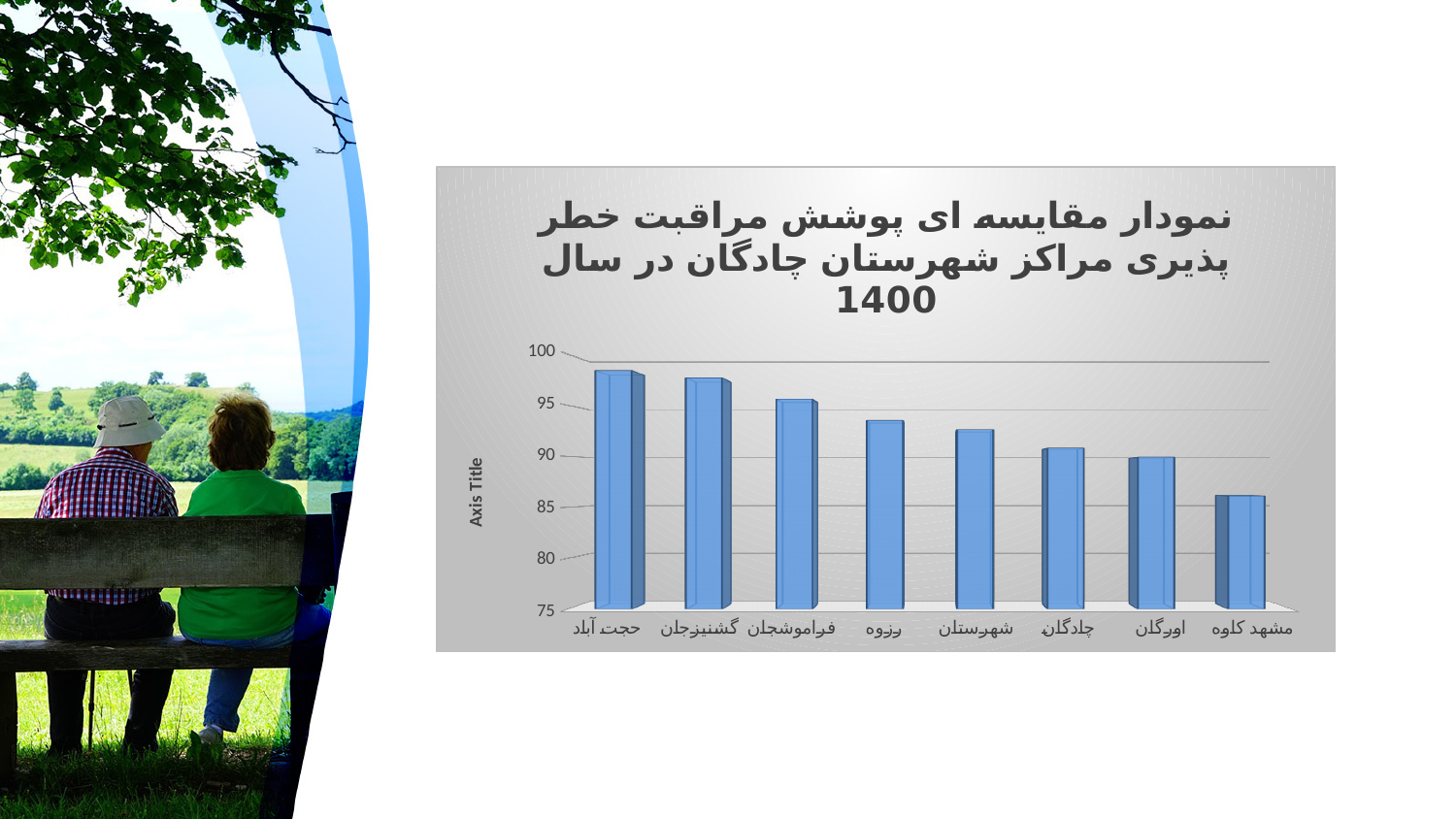
Do the values rise or fall moving from left to right along the x axis? fall Is the value for گشنیزجان greater or less than 95? greater Is the value for حجت آباد greater or less than 95? greater Is the value for شهرستان greater or less than 90? greater Which category has the highest value in the chart? حجت آباد How many categories are shown on the x axis of the chart? 8 Which is larger, the value for فراموشجان or the value for اورگان? فراموشجان Which category has the lowest value in the chart? مشهد کاوه What kind of chart is shown on the slide? bar chart What is the label shown on the vertical axis of the chart? Axis Title